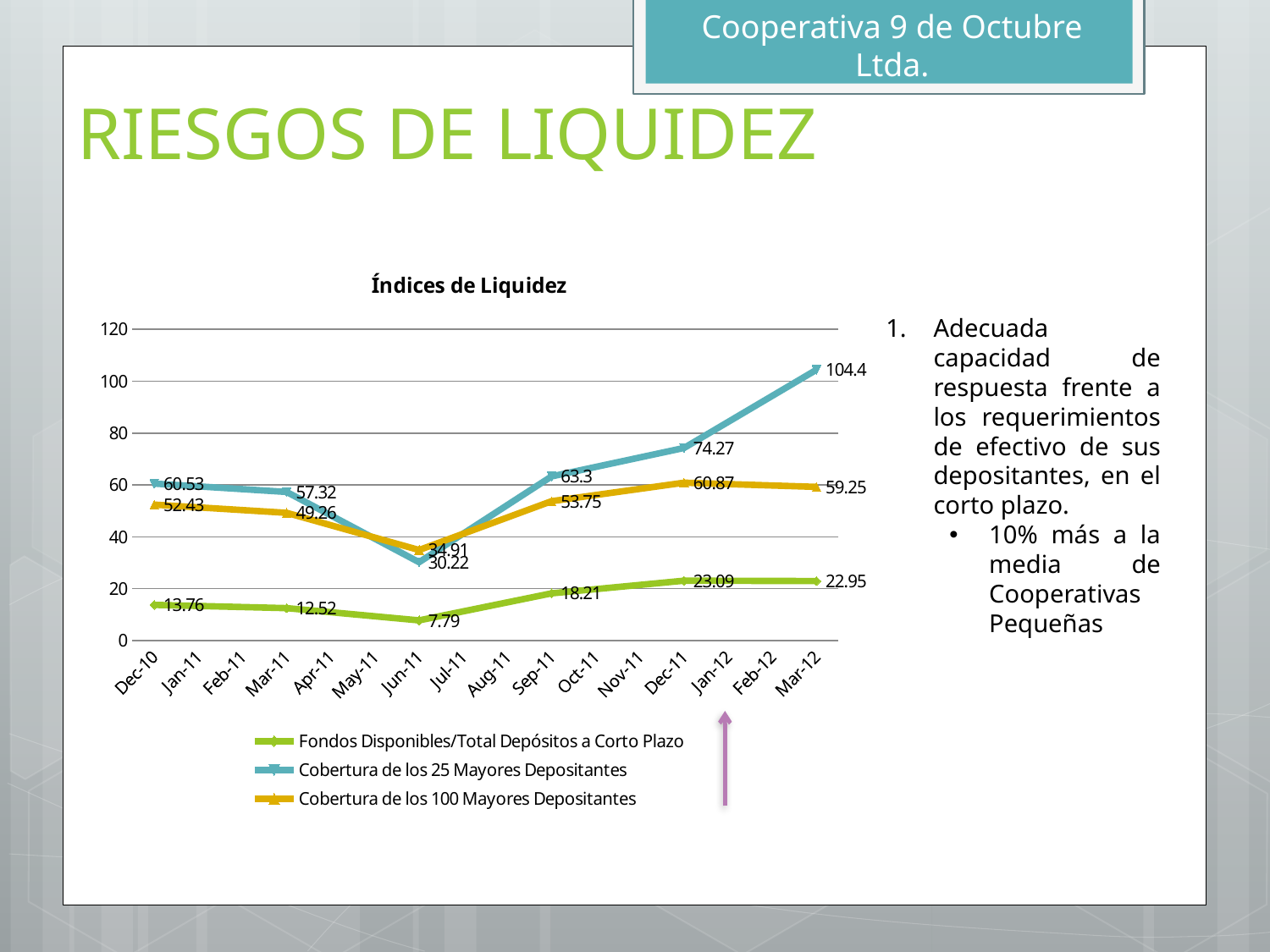
What is the value of Cobertura de los 100 Mayores Depositantes in Dec-11? 60.87 What is the difference between the Cobertura de los 25 Mayores Depositantes values in Mar-12 and Dec-11? 30.13 What type of chart is shown on the slide? line chart In which month does Fondos Disponibles/Total Depósitos a Corto Plazo reach its highest value? Dec-11 Which is larger in Dec-10: Cobertura de los 25 Mayores Depositantes or Cobertura de los 100 Mayores Depositantes? Cobertura de los 25 Mayores Depositantes What is the title of the chart? Índices de Liquidez In which month does Cobertura de los 25 Mayores Depositantes reach its lowest value? Jun-11 How many data points are labeled for the Cobertura de los 100 Mayores Depositantes series? 6 Is the value of Cobertura de los 25 Mayores Depositantes in Mar-12 greater or less than 100? greater How many series does the legend list? 3 What is the value of Cobertura de los 25 Mayores Depositantes in Mar-12? 104.4 What is the value of Fondos Disponibles/Total Depósitos a Corto Plazo in Jun-11? 7.79